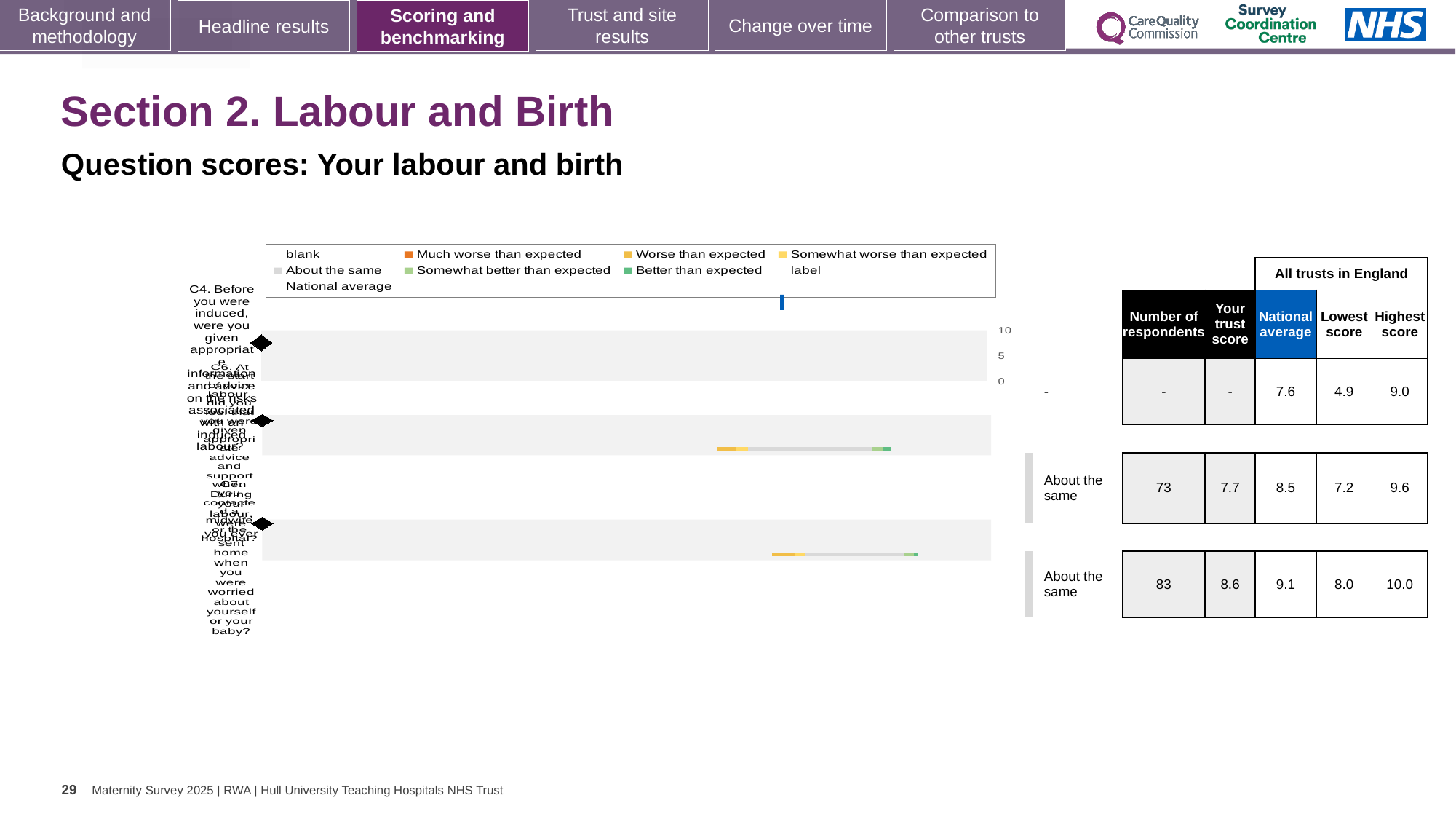
In the table beside the chart, what is the number of respondents in the second row? 73 In the table beside the chart, what is the lowest score in the first row? 4.9 What is the highest tick value shown on the chart's axis? 10 What colour is the 'Much worse than expected' legend entry? orange What kind of chart is shown on the slide? bar chart In the table beside the chart, what is the national average in the first row? 7.6 In the table beside the chart, what is the difference between the highest score and the lowest score in the third row? 2.0 How many entries does the chart legend list? 9 In the table beside the chart, which is larger in the second row: the trust score or the national average? national average In the table beside the chart, what is the trust score in the third row? 8.6 How many question rows (C4, C6, C7) are plotted on the chart? 3 In the table beside the chart, which row has the highest 'Highest score' value? third row (10.0)